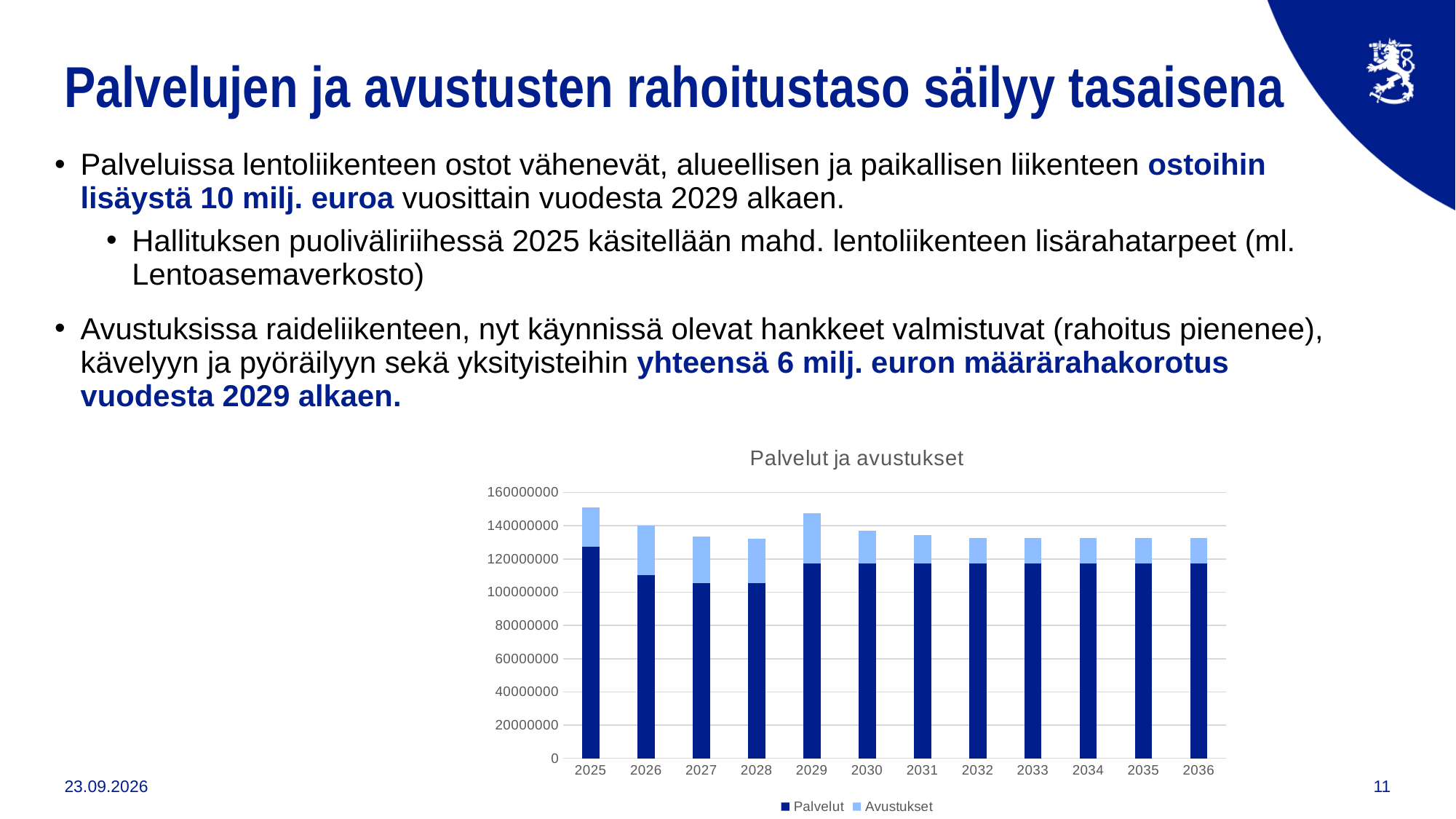
Is the total bar for 2029 greater or less than 140000000? greater Which is larger, the Palvelut value for 2029 or the Palvelut value for 2028? 2029 Which year has the highest total bar in the chart? 2025 How many years are shown on the x axis of the chart? 12 Which is larger, the total bar for 2025 or the total bar for 2026? 2025 How many series does the chart legend list? 2 What kind of chart is shown on the slide? stacked bar chart Is the Palvelut value for 2027 greater or less than 120000000? less Which two series are listed in the chart legend? Palvelut and Avustukset Is the total bar for 2025 greater or less than 140000000? greater What is the title of the chart? Palvelut ja avustukset